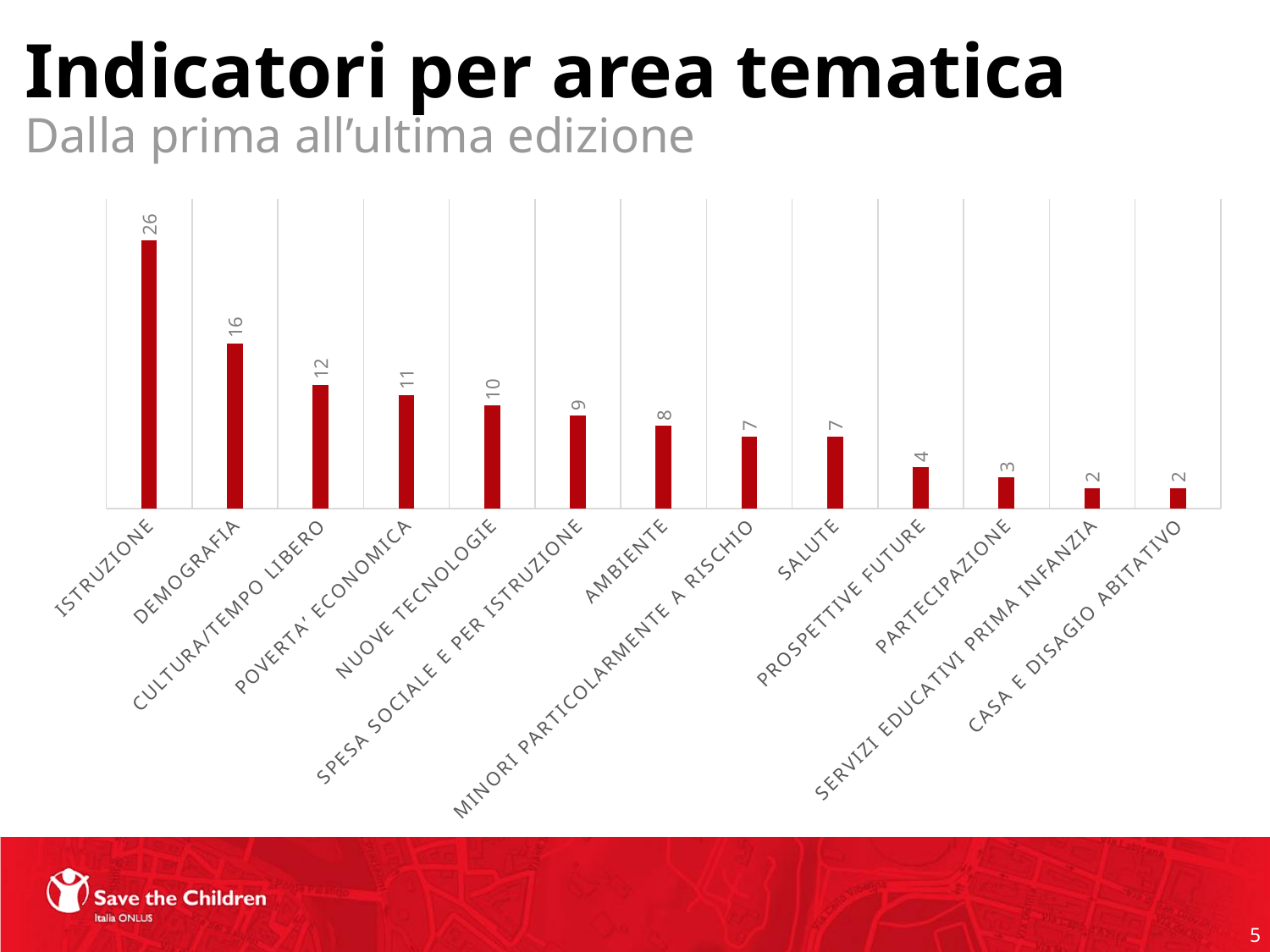
What kind of chart is shown on the slide? bar chart What is the value for PARTECIPAZIONE? 3 What is the value for NUOVE TECNOLOGIE? 10 What is the difference between the values for CULTURA/TEMPO LIBERO and AMBIENTE? 4 What is the value for DEMOGRAFIA? 16 What is the value for ISTRUZIONE? 26 Which category has the highest value? ISTRUZIONE Do the values rise or fall from left to right along the x axis? fall Which is larger, the value for POVERTA' ECONOMICA or the value for SALUTE? POVERTA' ECONOMICA What colour are the bars in the chart? red How many categories are shown in the chart? 13 What is the difference between the values for ISTRUZIONE and DEMOGRAFIA? 10